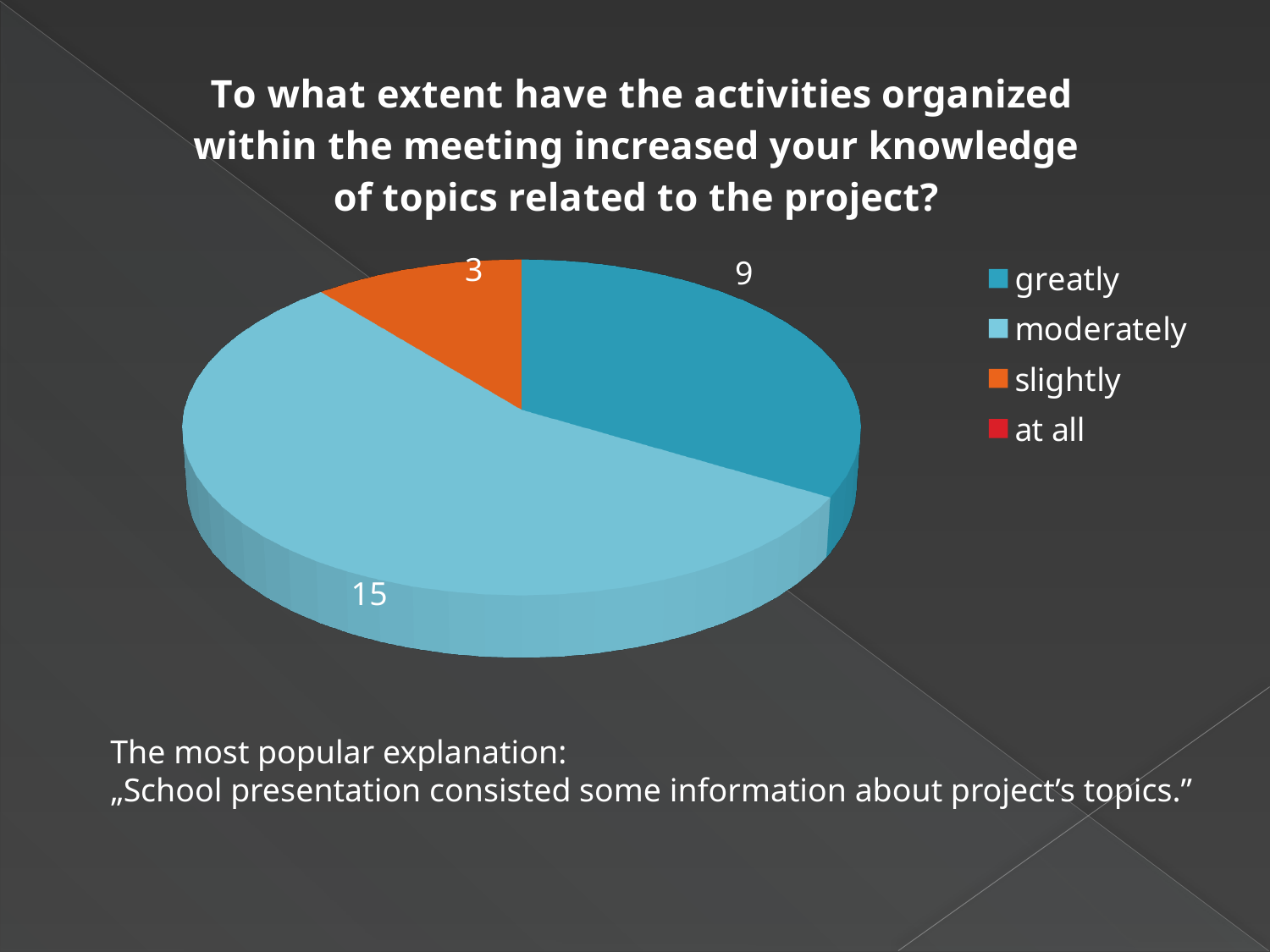
How many entries does the legend list? 4 Which category has the largest slice of the pie? moderately What kind of chart is shown on the slide? pie chart What is the difference between the "greatly" and "slightly" values? 6 What is the value for the "moderately" slice? 15 What is the value for the "greatly" slice? 9 What is the difference between the "moderately" and "greatly" values? 6 What colour is the "slightly" slice? orange Which labelled slice has the smallest value? slightly Which is larger, the value for "greatly" or the value for "slightly"? greatly What is the value for the "slightly" slice? 3 How many slices are visible in the pie? 3